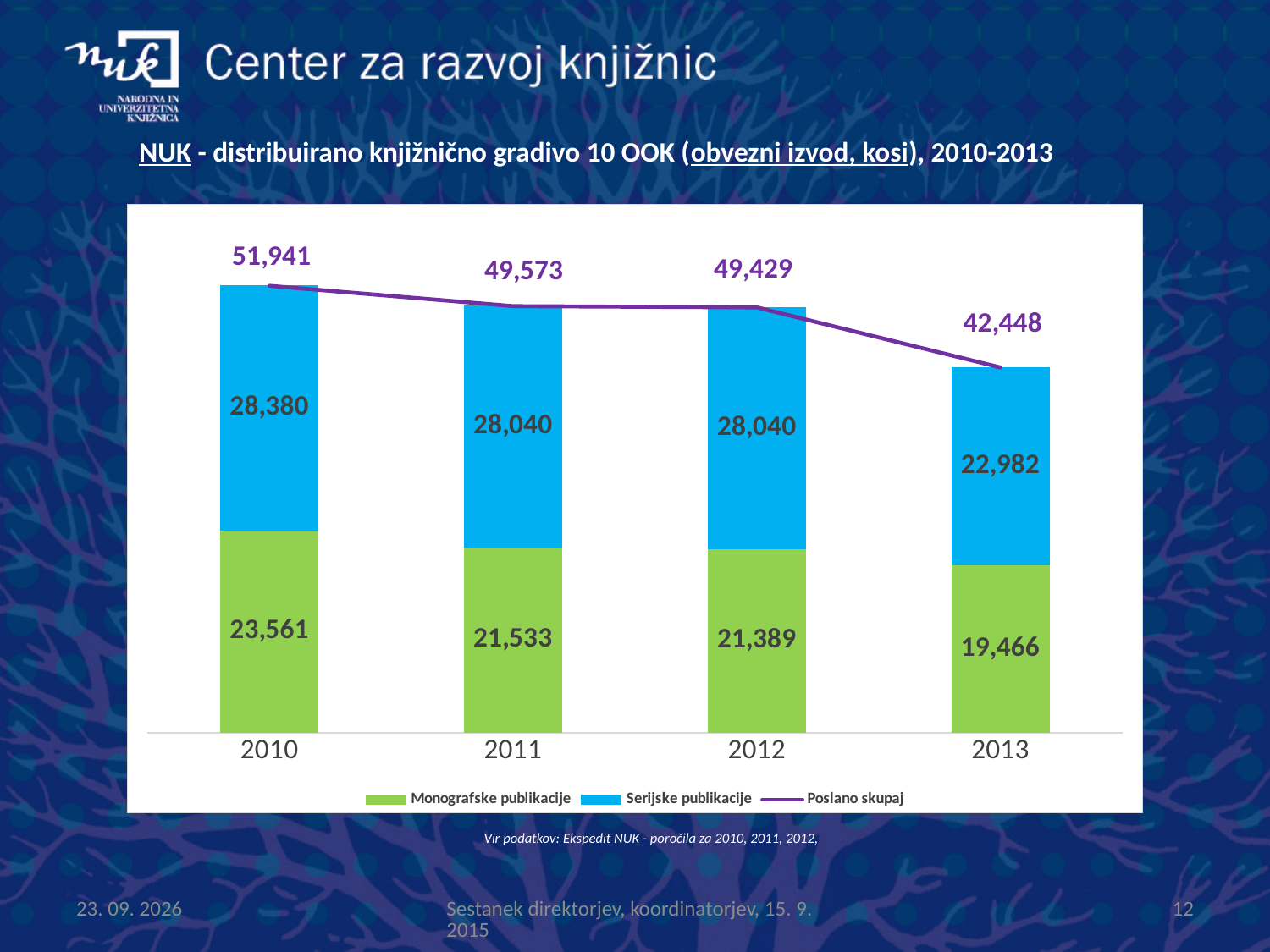
What colour represents Serijske publikacije in the chart? Blue Does the Poslano skupaj line rise or fall from 2010 to 2013? Fall Which is larger: Serijske publikacije in 2010 or Serijske publikacije in 2013? Serijske publikacije in 2010 Which year has the highest Poslano skupaj value? 2010 How many series does the legend list? 3 What is the difference between the Poslano skupaj values for 2010 and 2013? 9,493 What is the value for Serijske publikacije in 2013? 22,982 What is the value for Monografske publikacije in 2010? 23,561 How many years are shown on the x axis? 4 What is the Poslano skupaj value for 2011? 49,573 Which year has the lowest value for Monografske publikacije? 2013 What kind of chart is this? Stacked bar chart with a line